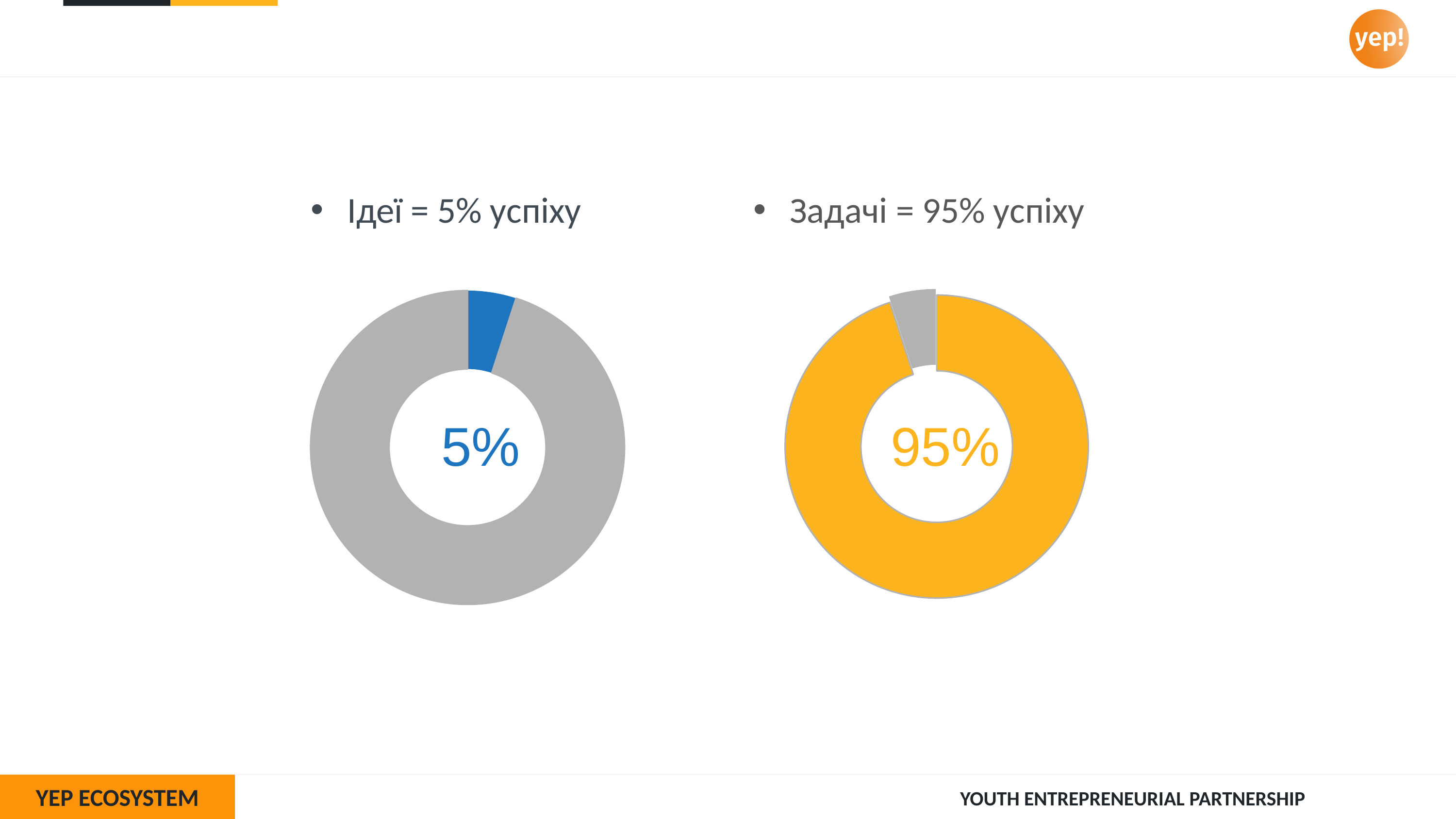
According to the slide, what share of success do tasks (Задачі) account for? 95% Is the value shown in the right chart (Задачі) greater or less than 50%? greater What kind of chart is shown on the left side of the slide? Donut chart In the left chart (Ідеї), what percentage is printed in the centre? 5% In the right chart (Задачі), what percentage is printed in the centre? 95% In the right chart (Задачі), what colour is the 95% slice? Orange According to the slide, what share of success do ideas (Ідеї) account for? 5% In the left chart (Ідеї), what colour is the 5% slice? Blue What kind of chart is shown on the right side of the slide? Donut chart Which is larger: the share for Ідеї or the share for Задачі? Задачі What is the difference between the percentage shown for Задачі and the percentage shown for Ідеї? 90% How many donut charts are on the slide? 2